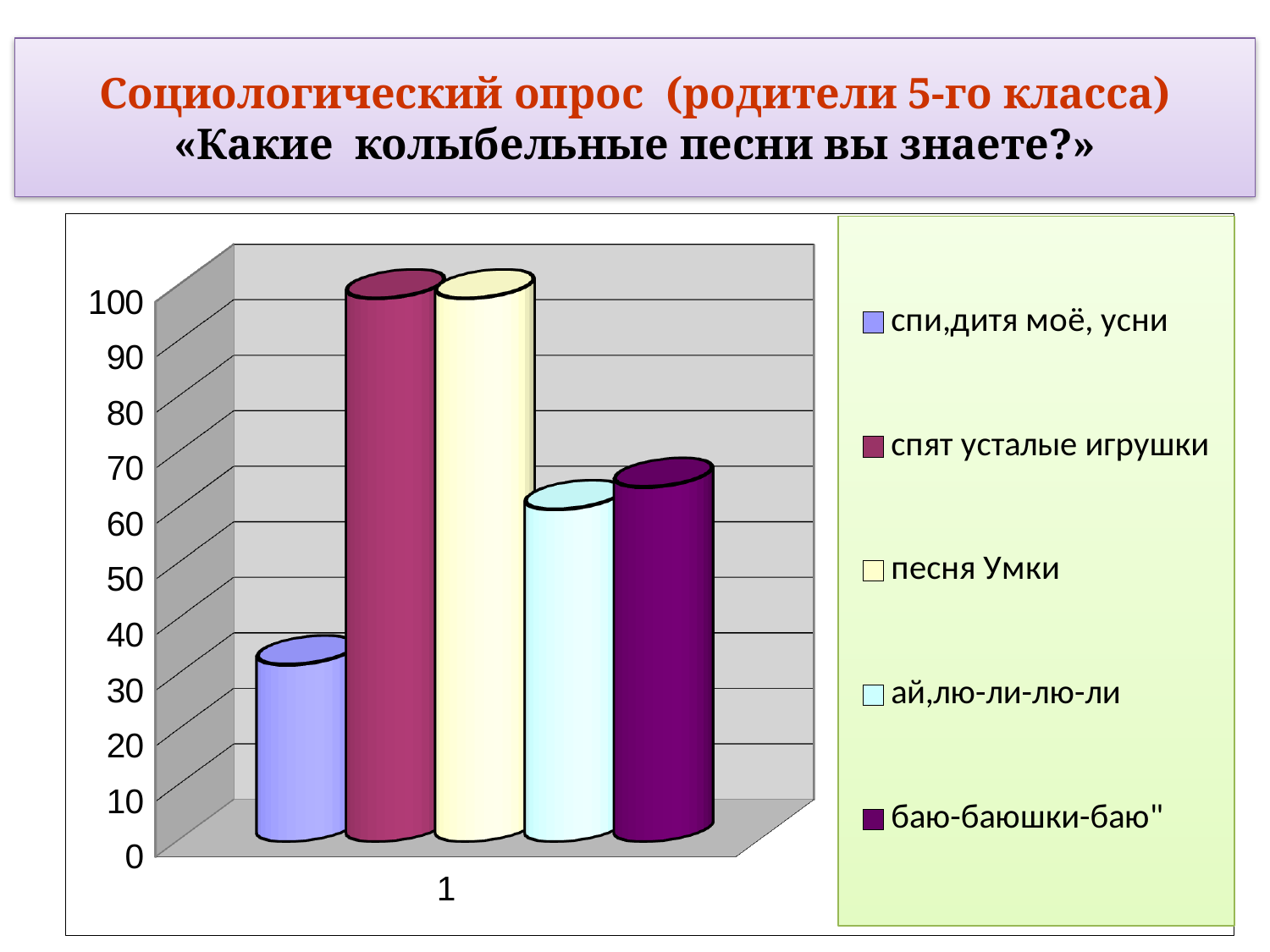
Is the value for спят усталые игрушки greater or less than 90? greater What kind of chart is shown on the slide? bar chart Is the value for спи,дитя моё, усни greater or less than 50? less Which is larger, the value for спят усталые игрушки or the value for спи,дитя моё, усни? спят усталые игрушки How many series does the legend list? 5 Is the value for песня Умки greater or less than 80? greater Which series is shown in the pale yellow colour in the legend? песня Умки How many categories are shown on the x axis? 1 Which series has the lowest value? спи,дитя моё, усни